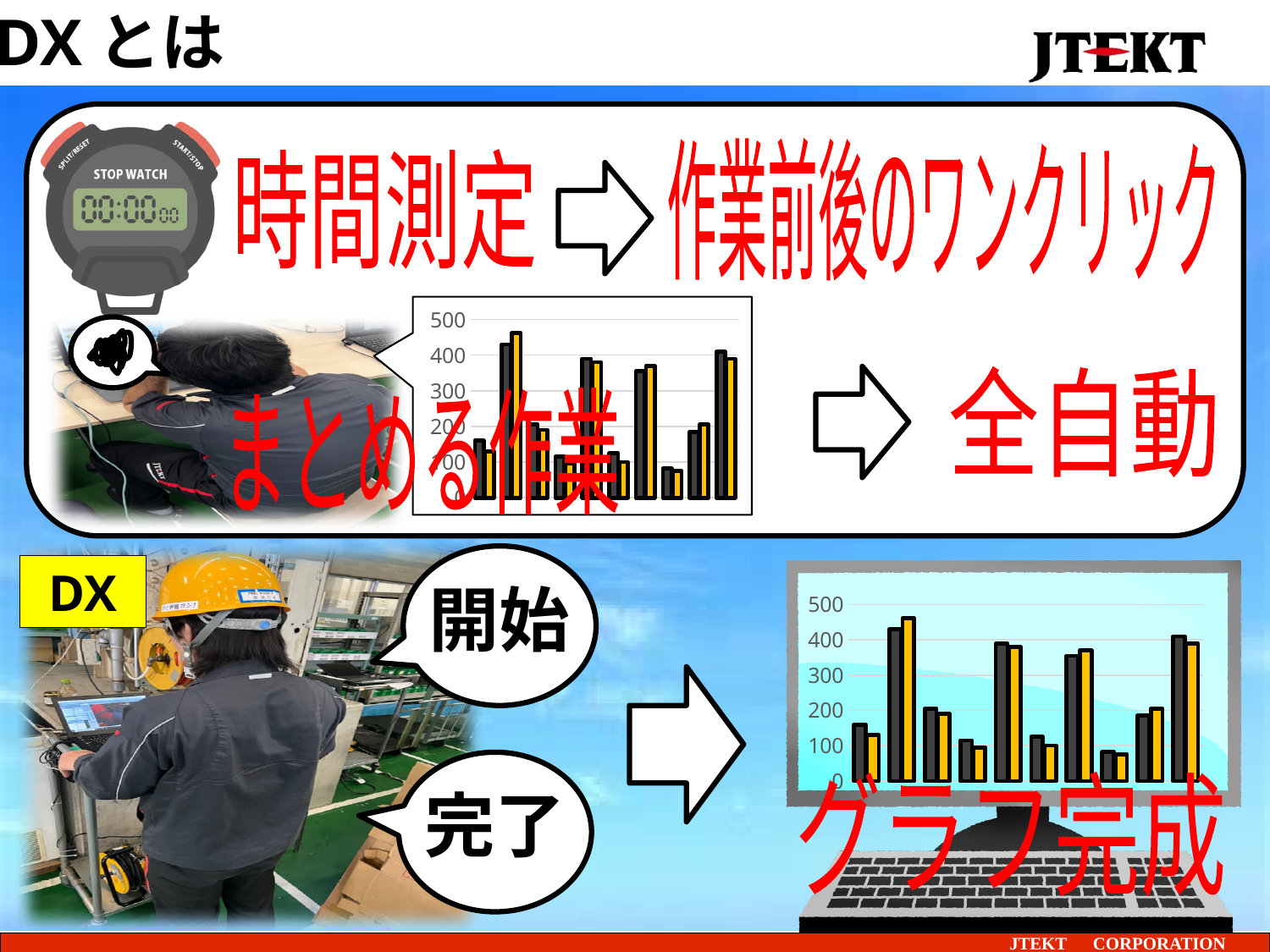
On the bottom-right laptop chart, what two colours are the bars? dark grey and orange What kind of chart is shown inside the top box of the slide, next to the seated worker? bar chart On the bottom-right laptop chart, is the shortest bar greater or less than 100? less On the chart in the top box of the slide, what is the lowest value labelled on the vertical axis? 0 What kind of chart is shown on the laptop screen at the bottom right of the slide? bar chart On the chart in the top box of the slide, is the tallest bar greater or less than 400? greater On the bottom-right laptop chart, is the tallest bar greater or less than 500? less On the bottom-right laptop chart, what is the highest value labelled on the vertical axis? 500 On the bottom-right laptop chart, how many tick labels are printed on the vertical axis? 6